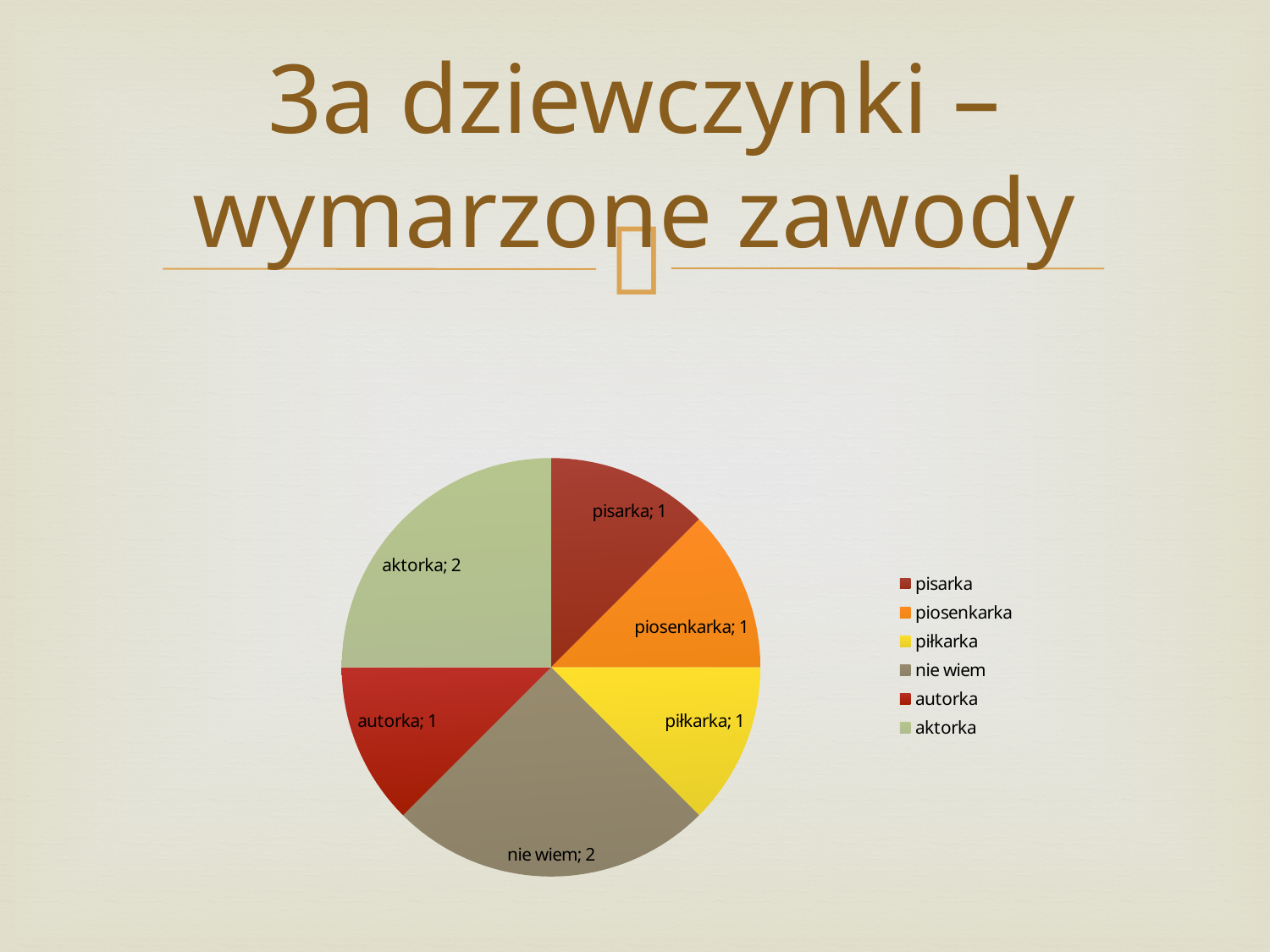
Which two categories share the highest value in the pie chart? nie wiem and aktorka What kind of chart is shown on the slide? pie chart What share of the pie does the pisarka slice represent? 12.5% What is the value for piosenkarka? 1 How many entries does the legend list? 6 Which is larger, the value for aktorka or the value for autorka? aktorka How many slices does the pie chart have? 6 What is the value for aktorka? 2 What share of the pie does the aktorka slice represent? 25% What is the value for piłkarka? 1 What is the value for nie wiem? 2 What is the difference between the value for nie wiem and the value for pisarka? 1